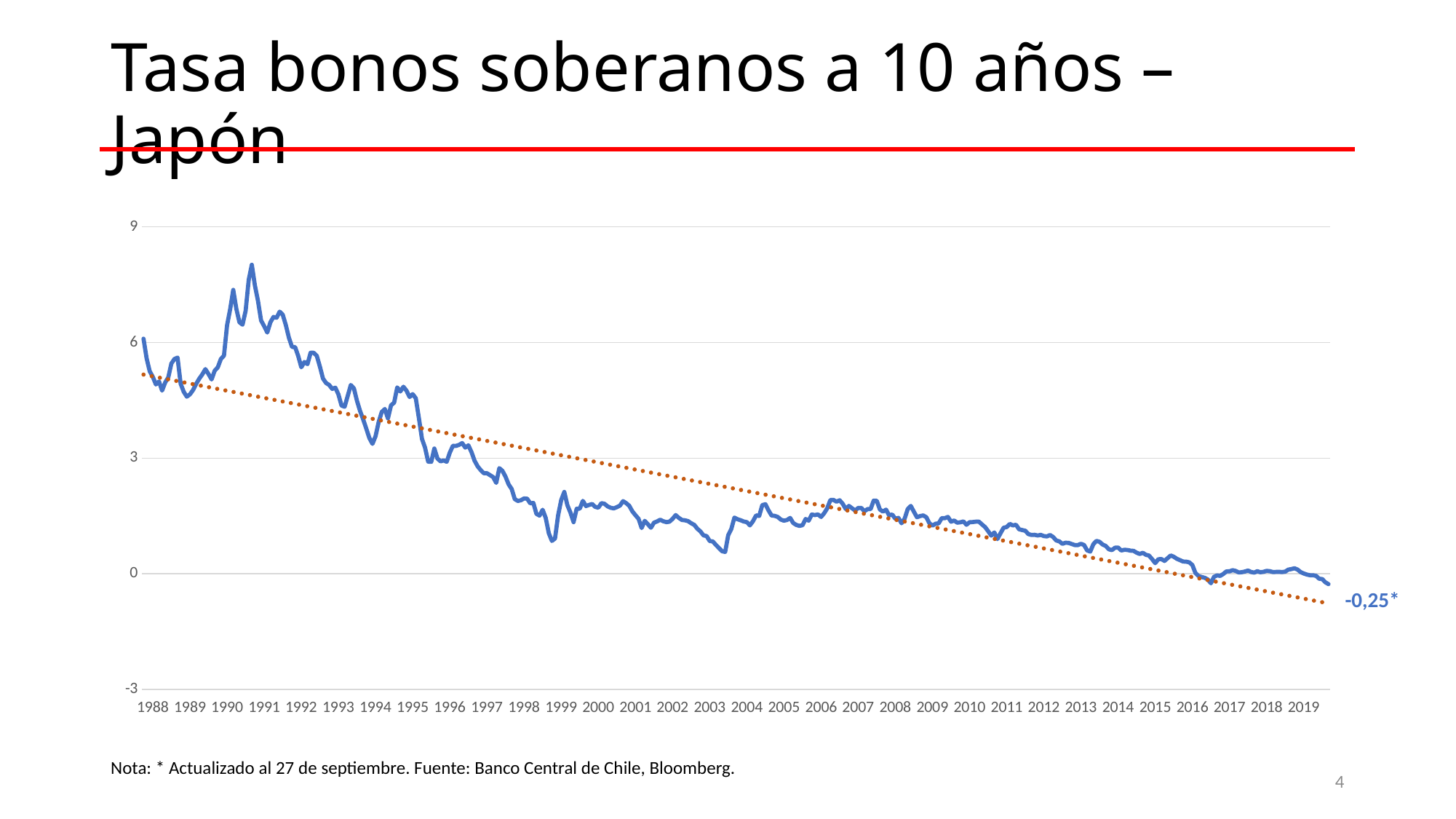
What kind of chart is shown on the slide? line chart Is the value at the start of the series in 1988 greater or less than 3? greater Which is larger, the value in 1988 or the value in 2019? 1988 What is the title of the slide? Tasa bonos soberanos a 10 años – Japón Is the value in 2003 greater or less than 3? less What is the value printed at the end of the line for the latest data point? -0,25 Is the peak value reached around 1990–1991 greater or less than 6? greater Which is larger, the value in 1995 or the value in 2005? 1995 How many year labels are shown on the x axis? 32 What sources are cited in the note below the chart? Banco Central de Chile, Bloomberg Overall, does the 10-year sovereign bond rate for Japan rise or fall from 1988 to 2019? fall